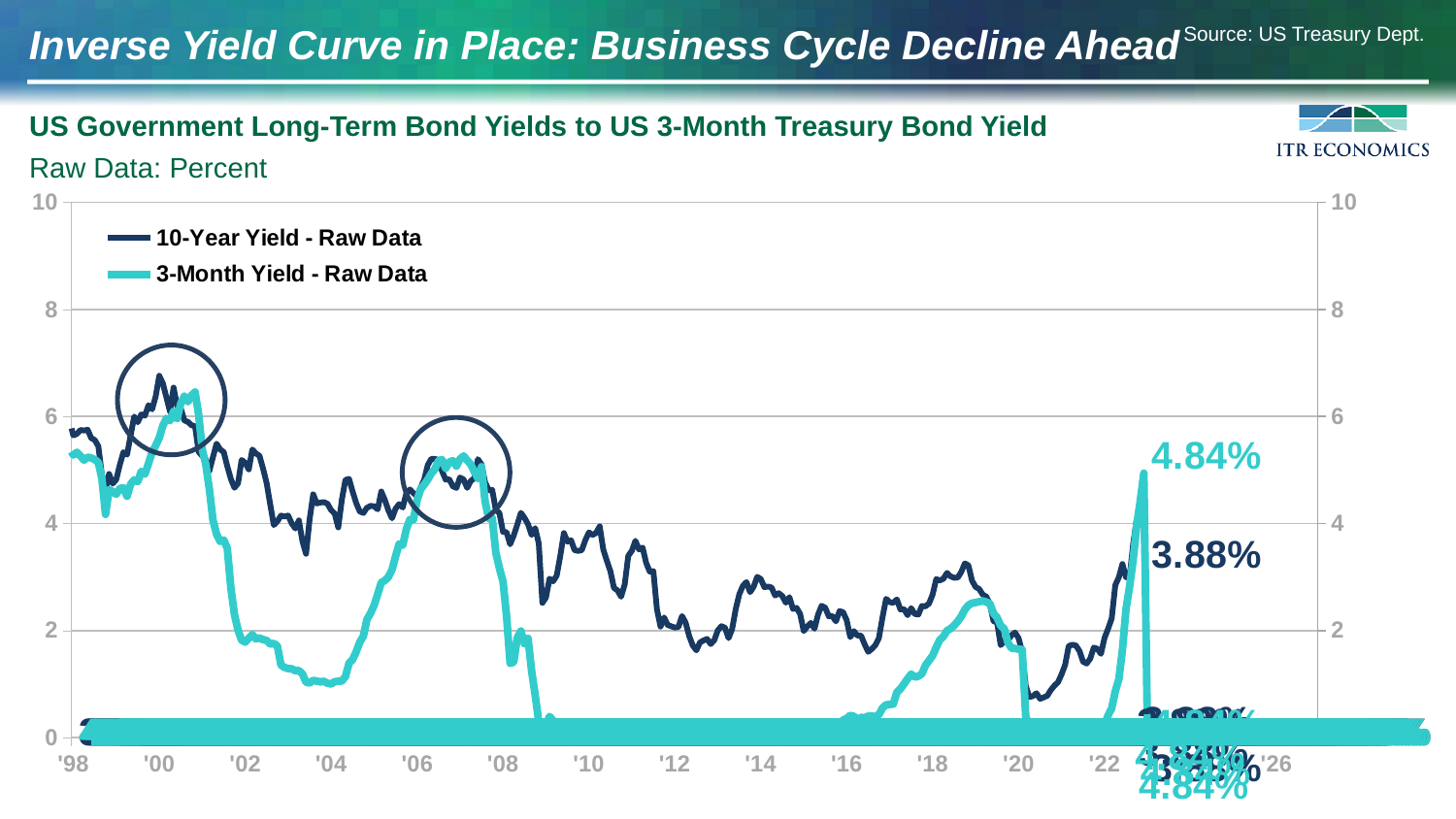
Is the 3-Month Yield around the year 2012 greater or less than 2? less What is the latest value shown for the 3-Month Yield - Raw Data series? 4.84% Does the 3-Month Yield rise or fall between 2020 and 2022? rise How many series does the legend list? 2 What kind of chart is shown on the slide? Line chart What is the difference between the labelled 3-Month Yield value (4.84%) and the labelled 10-Year Yield value (3.88%)? 0.96% What is the latest value shown for the 10-Year Yield - Raw Data series? 3.88% Is the 10-Year Yield around the year 2012 greater or less than 4? less Which colour represents the 3-Month Yield - Raw Data series? Teal What is the title of the chart? US Government Long-Term Bond Yields to US 3-Month Treasury Bond Yield At the end of the series, which is higher: the 3-Month Yield or the 10-Year Yield? 3-Month Yield